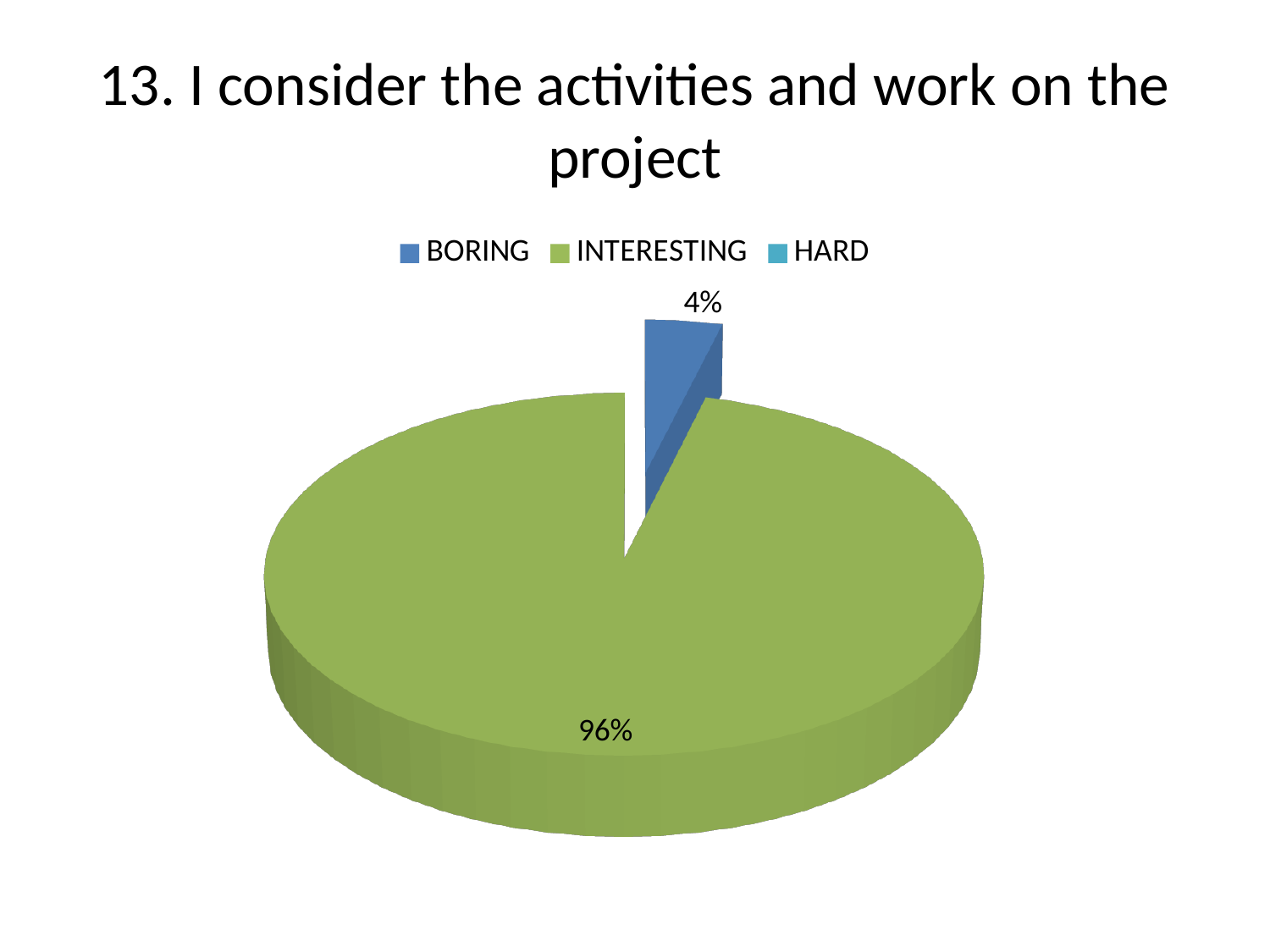
What kind of chart is shown on the slide? pie chart Which is larger, the INTERESTING slice or the BORING slice? INTERESTING What percentage of respondents chose INTERESTING? 96% What is the title of the slide? 13. I consider the activities and work on the project Which category has the largest slice of the pie? INTERESTING How many entries does the legend list? 3 Which of the two labelled slices, BORING or INTERESTING, is smaller? BORING What colour is the INTERESTING slice? green What is the difference in percentage points between the INTERESTING and BORING slices? 92 What share of the pie does the INTERESTING slice represent? 96% What percentage of respondents chose BORING? 4%